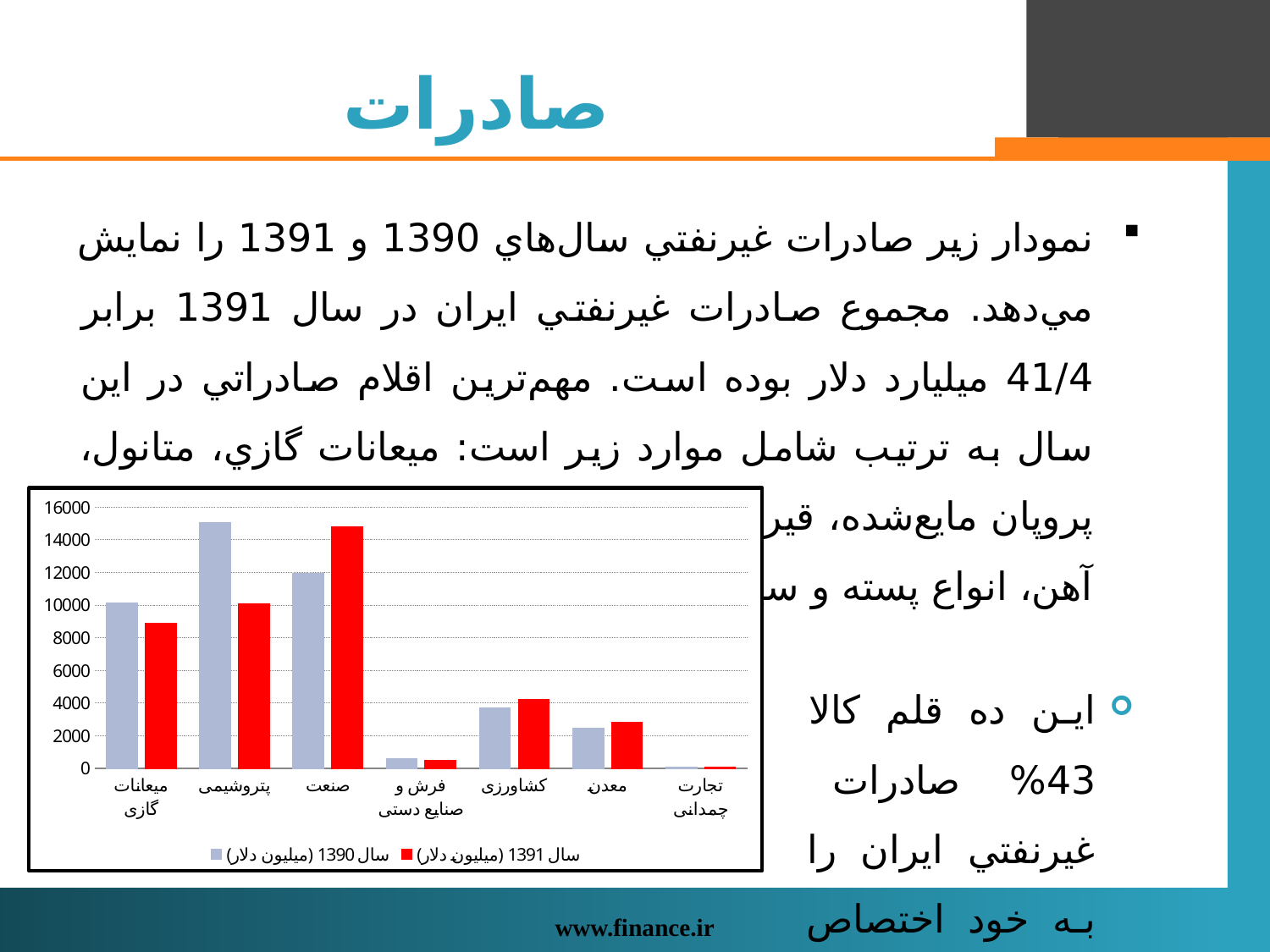
Is the value for فرش و صنایع دستی in the سال 1391 series greater or less than 2000? less Is the value for پتروشیمی in the سال 1391 series greater or less than 14000? less For صنعت, which series has the larger value, سال 1391 or سال 1390? سال 1391 How many series does the chart legend list? 2 How many categories are shown on the x axis of the chart? 7 Which category has the highest value for the سال 1390 (میلیون دلار) series? پتروشیمی Which category has the lowest values in the chart? تجارت چمدانی For پتروشیمی, which series has the larger value, سال 1391 or سال 1390? سال 1390 What kind of chart is shown on the slide? bar chart What colour are the bars for the سال 1390 (میلیون دلار) series? light blue Which category has the highest value for the سال 1391 (میلیون دلار) series? صنعت